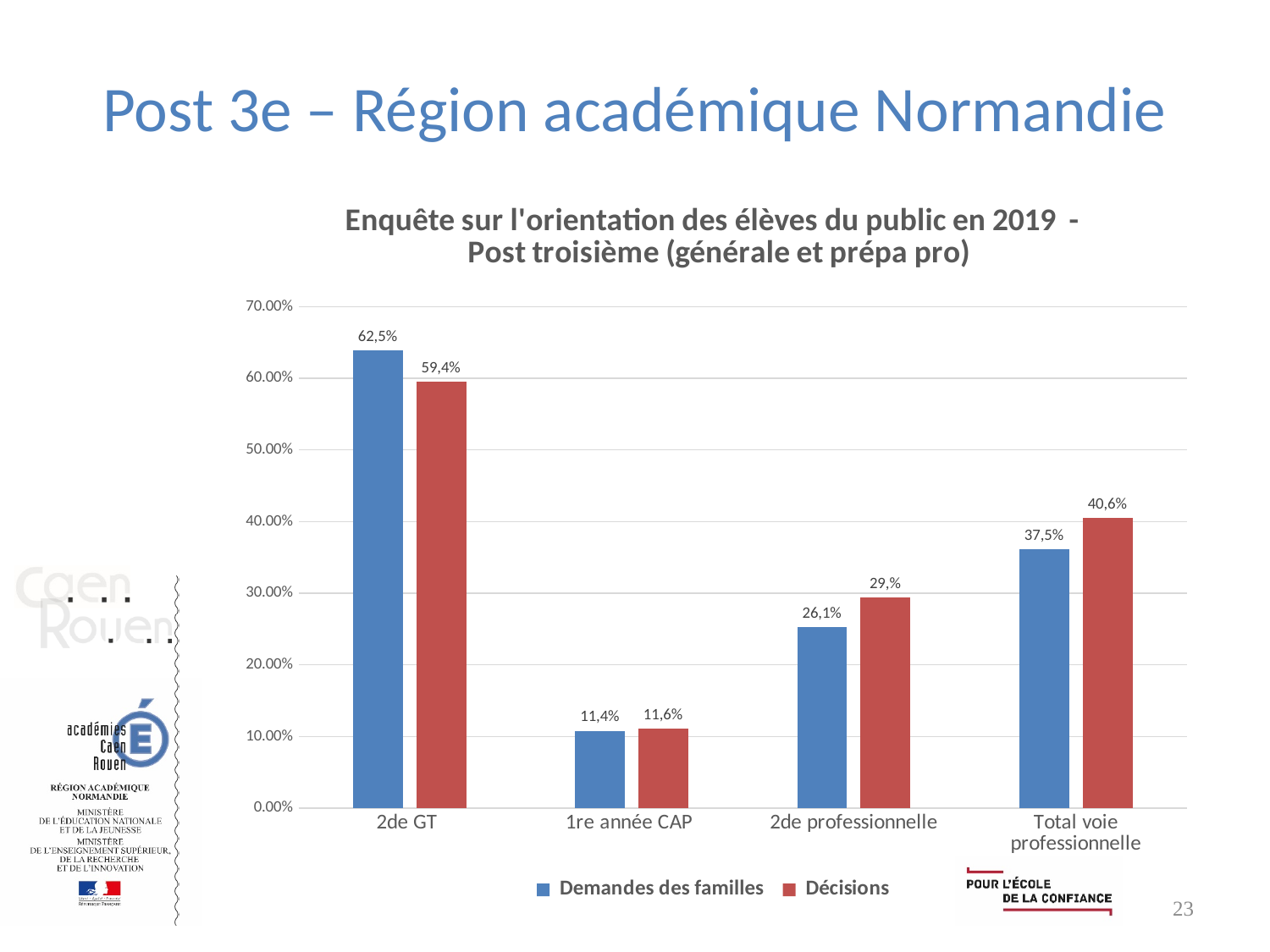
Which category has the highest value for Demandes des familles? 2de GT For Total voie professionnelle, which is larger: Demandes des familles or Décisions? Décisions What is the value for Demandes des familles for 1re année CAP? 11,4% What is the value for Décisions for Total voie professionnelle? 40,6% What is the value for Décisions for 2de GT? 59,4% Is the value for Décisions for 2de professionnelle greater or less than 20.00%? greater How many categories are shown on the x axis? 4 What is the difference between Demandes des familles and Décisions for 2de GT? 3,1% How many series does the legend list? 2 Which category has the lowest value for Décisions? 1re année CAP What is the value for Demandes des familles for 2de GT? 62,5% What is the value for Demandes des familles for 2de professionnelle? 26,1%